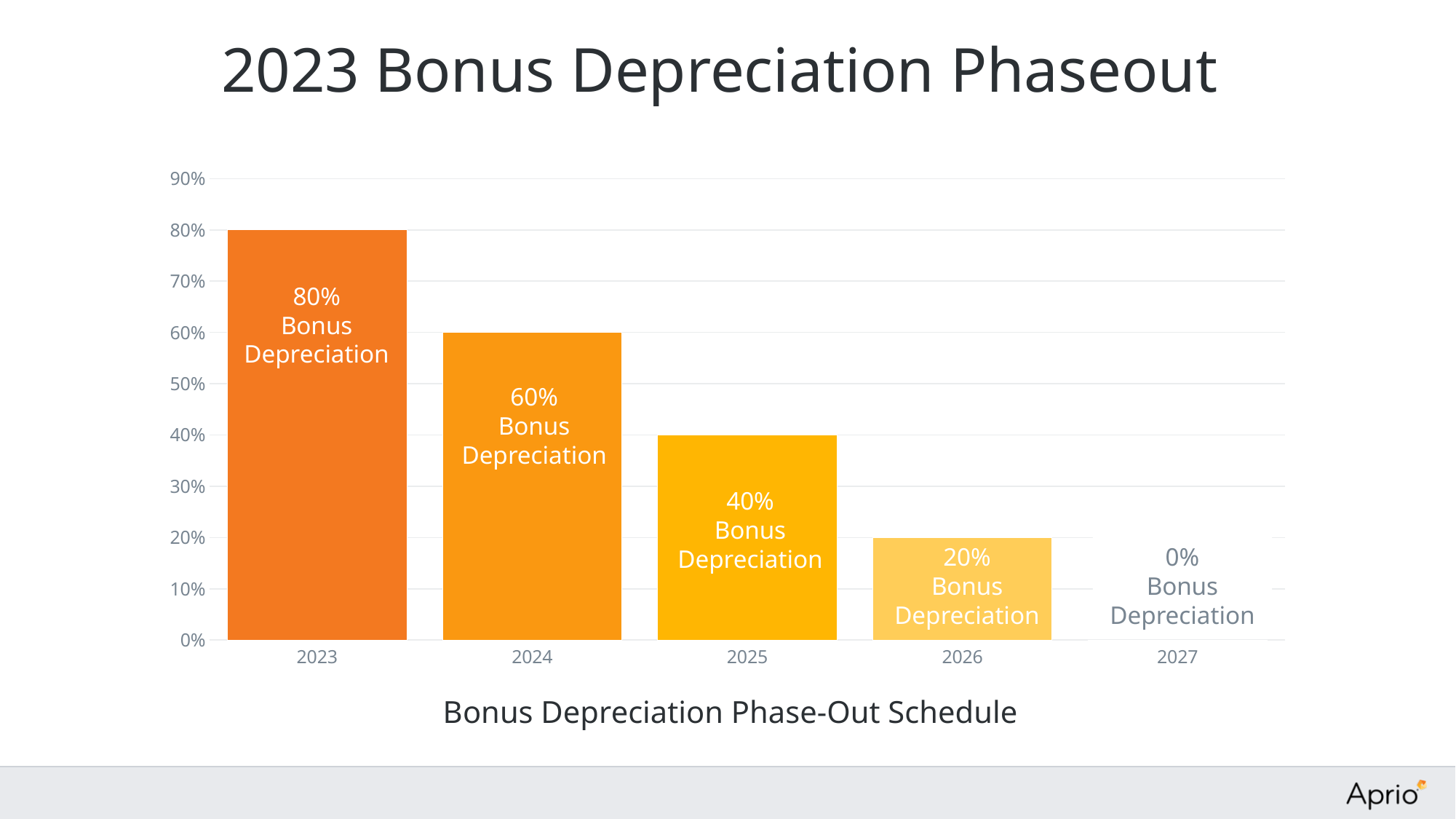
What is the bonus depreciation percentage for 2025? 40% What is the bonus depreciation percentage for 2027? 0% What is the bonus depreciation percentage for 2023? 80% What is the caption shown below the chart's x axis? Bonus Depreciation Phase-Out Schedule Do the bonus depreciation percentages rise or fall from 2023 to 2027? Fall Which year has the highest bonus depreciation percentage? 2023 How many years are shown on the x axis of the chart? 5 Which year has the lowest bonus depreciation percentage? 2027 What kind of chart is shown on the slide? Bar chart Which year has a larger bonus depreciation percentage, 2025 or 2026? 2025 By how much does the bonus depreciation percentage drop from 2023 to 2024? 20% What is the difference between the bonus depreciation percentages for 2024 and 2026? 40%